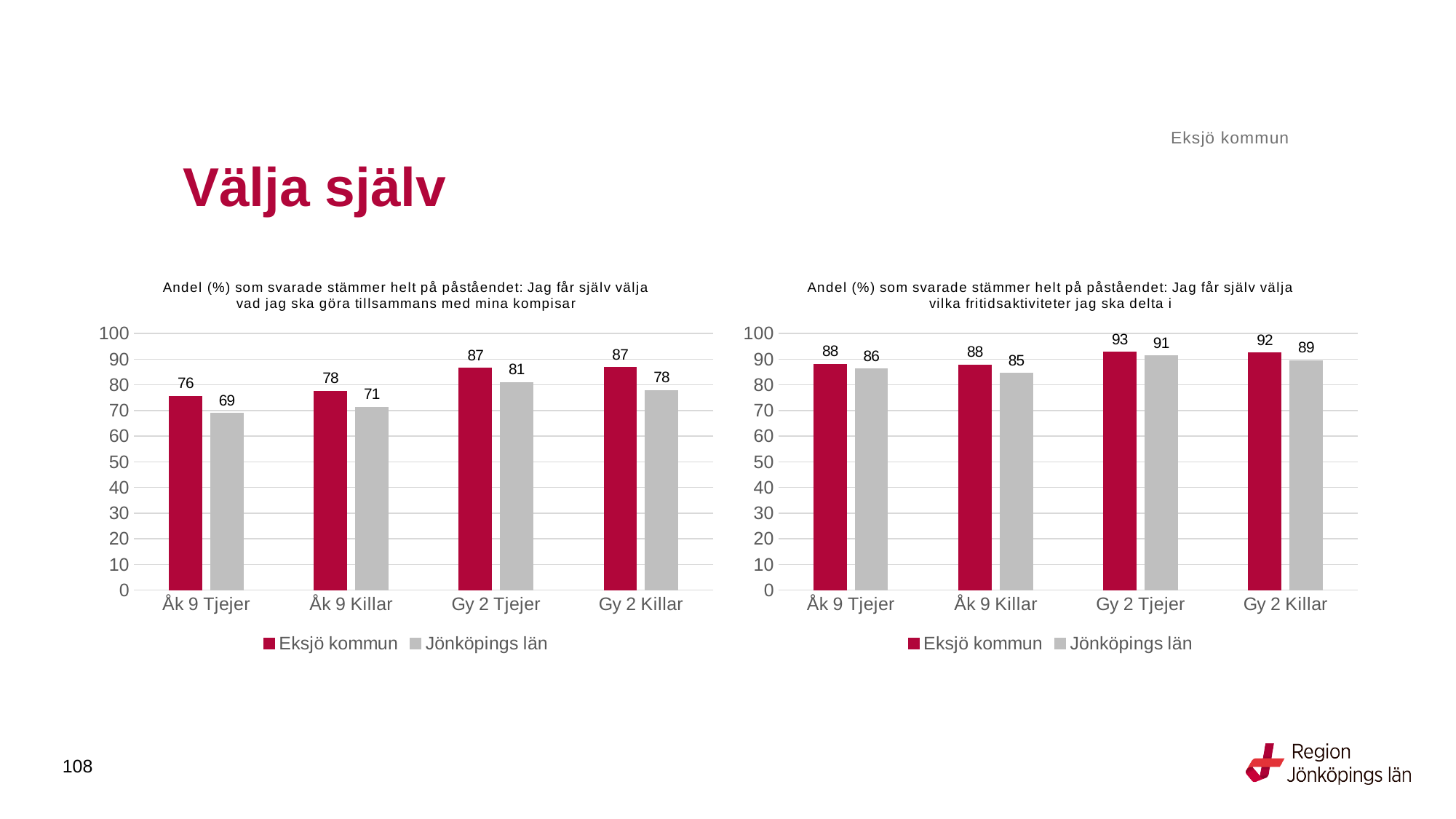
In the left chart (about choosing what to do with friends), what is the difference between Eksjö kommun and Jönköpings län for Gy 2 Killar? 9 How many categories are shown on the x axis of the right chart (about choosing leisure activities)? 4 In the left chart (about choosing what to do with friends), which category has the lowest value for Jönköpings län? Åk 9 Tjejer In the left chart (about choosing what to do with friends), what is the value for Jönköpings län for Gy 2 Killar? 78 What kind of chart is the right chart (about choosing leisure activities)? Bar chart In the left chart (about choosing what to do with friends), which colour represents Eksjö kommun? Red In the right chart (about choosing leisure activities), what is the difference between Eksjö kommun and Jönköpings län for Gy 2 Tjejer? 2 How many series does the legend of the left chart (about choosing what to do with friends) list? 2 In the right chart (about choosing leisure activities), what is the value for Jönköpings län for Åk 9 Killar? 85 In the right chart (about choosing leisure activities), which category has the highest value for Eksjö kommun? Gy 2 Tjejer In the left chart (about choosing what to do with friends), which is larger for Åk 9 Killar: Eksjö kommun or Jönköpings län? Eksjö kommun In the left chart (about choosing what to do with friends), what is the value for Eksjö kommun for Åk 9 Tjejer? 76